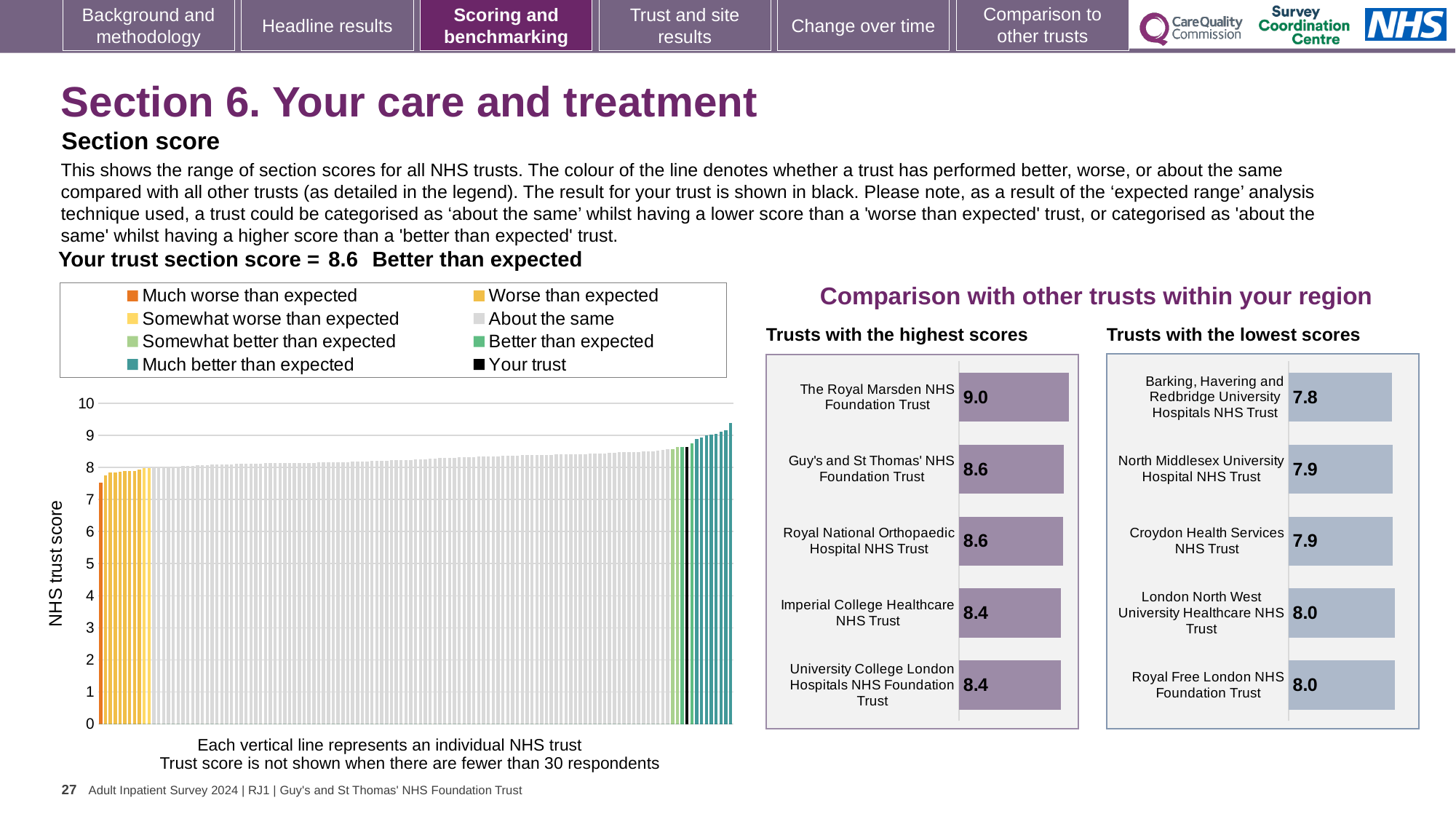
In the 'Trusts with the highest scores' chart, what is the score for Imperial College Healthcare NHS Trust? 8.4 In the 'Trusts with the lowest scores' chart, what is the score for Barking, Havering and Redbridge University Hospitals NHS Trust? 7.8 In the 'Trusts with the highest scores' chart, what is the difference between the scores of The Royal Marsden NHS Foundation Trust and University College London Hospitals NHS Foundation Trust? 0.6 What kind of chart is the large chart with the 'NHS trust score' axis? Bar chart In the large 'NHS trust score' chart, do the bar values rise or fall from left to right? Rise In the 'Trusts with the highest scores' chart, what is the score for The Royal Marsden NHS Foundation Trust? 9.0 In the 'Trusts with the lowest scores' chart, which has the larger score: North Middlesex University Hospital NHS Trust or London North West University Healthcare NHS Trust? London North West University Healthcare NHS Trust In the 'Trusts with the highest scores' chart, which trust has the highest score? The Royal Marsden NHS Foundation Trust In the 'Trusts with the lowest scores' chart, what is the score for Royal Free London NHS Foundation Trust? 8.0 How many entries does the legend of the large 'NHS trust score' chart list? 8 In the 'Trusts with the lowest scores' chart, which trust has the lowest score? Barking, Havering and Redbridge University Hospitals NHS Trust How many trusts are shown in the 'Trusts with the highest scores' chart? 5